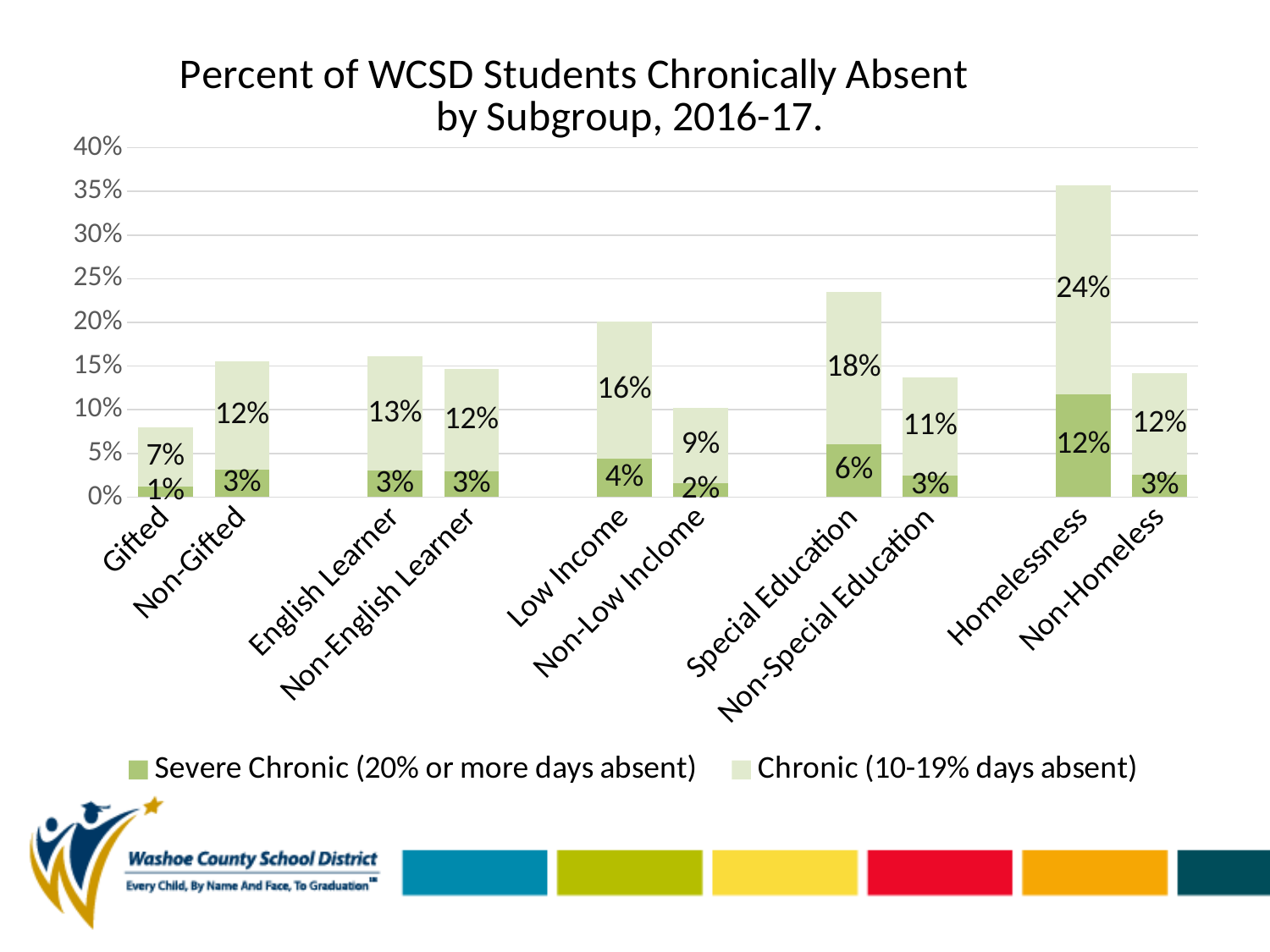
Which subgroup has the lowest Severe Chronic (20% or more days absent) value? Gifted How many series does the legend list? 2 What is the title of the chart? Percent of WCSD Students Chronically Absent by Subgroup, 2016-17. What is the total of the stacked bar for Gifted? 8% What is the Severe Chronic (20% or more days absent) value for Special Education? 6% How many subgroups (categories) are shown on the x axis? 10 Which subgroup has the highest Severe Chronic (20% or more days absent) value? Homelessness What is the Chronic (10-19% days absent) value for Low Income? 16% What is the Chronic (10-19% days absent) value for Homelessness? 24% What type of chart is shown on the slide? Stacked bar chart Which has a larger Chronic (10-19% days absent) value, English Learner or Non-English Learner? English Learner What is the difference between the Chronic (10-19% days absent) values for Low Income and Non-Low Income? 7%